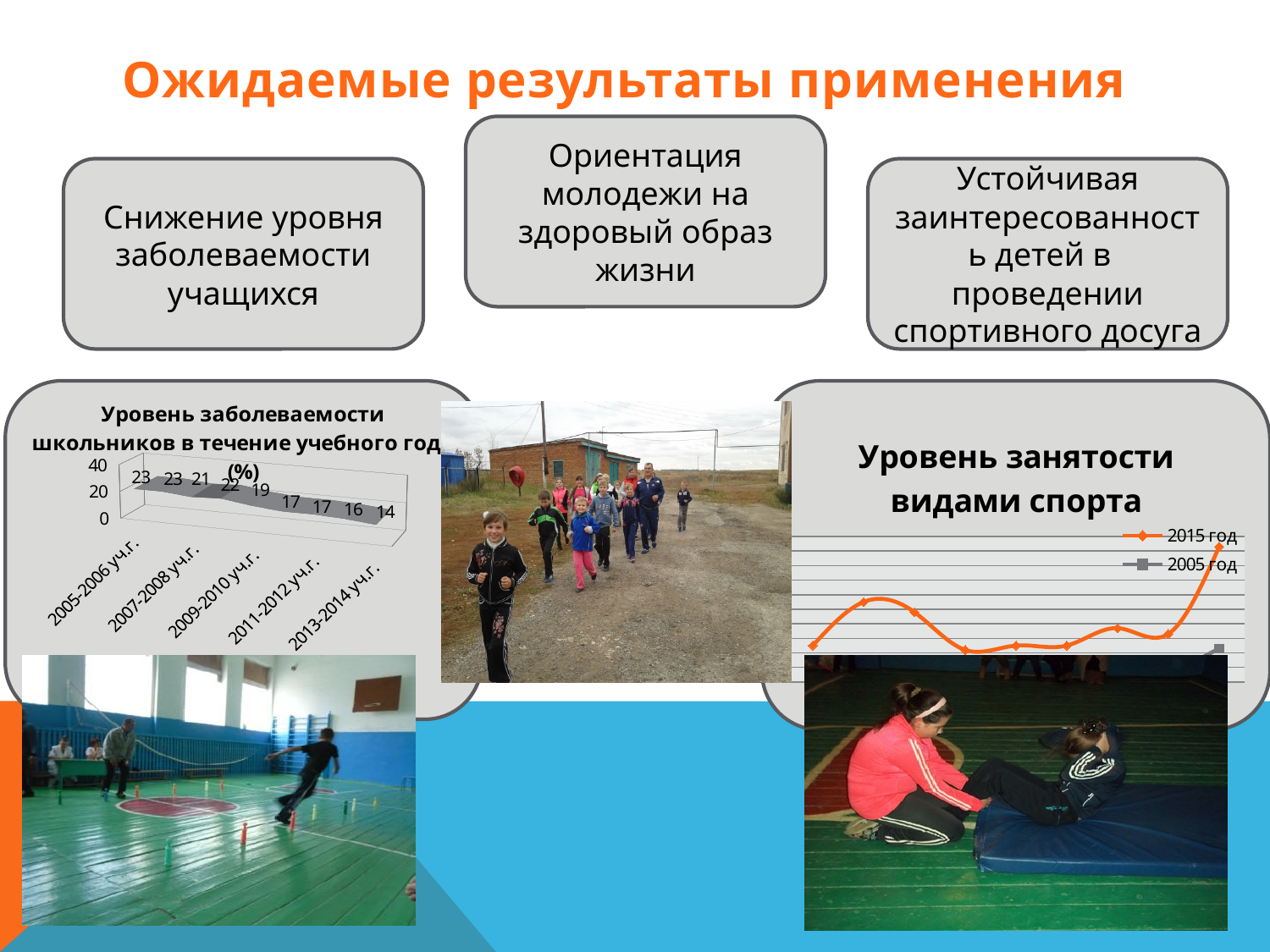
In the chart 'Уровень заболеваемости школьников в течение учебного года (%)', what is the value for 2013-2014 уч.г.? 14 In the chart 'Уровень заболеваемости школьников в течение учебного года (%)', what is the value for 2005-2006 уч.г.? 23 How many series does the legend of the chart 'Уровень занятости видами спорта' list? 2 In the chart 'Уровень заболеваемости школьников в течение учебного года (%)', which school year has the lowest value? 2013-2014 уч.г. In the chart 'Уровень заболеваемости школьников в течение учебного года (%)', what is the highest value shown? 23 In the chart 'Уровень заболеваемости школьников в течение учебного года (%)', is the value for 2013-2014 уч.г. greater or less than 20? less In the chart 'Уровень заболеваемости школьников в течение учебного года (%)', what is the value for 2009-2010 уч.г.? 19 What are the legend entries of the chart 'Уровень занятости видами спорта'? 2015 год, 2005 год In the chart 'Уровень заболеваемости школьников в течение учебного года (%)', what is the difference between the values for 2005-2006 уч.г. and 2013-2014 уч.г.? 9 In the chart 'Уровень заболеваемости школьников в течение учебного года (%)', how many data points are plotted? 9 In the chart 'Уровень заболеваемости школьников в течение учебного года (%)', which is larger: the value for 2005-2006 уч.г. or for 2013-2014 уч.г.? 2005-2006 уч.г. In the chart 'Уровень заболеваемости школьников в течение учебного года (%)', do the values rise or fall over the years? fall